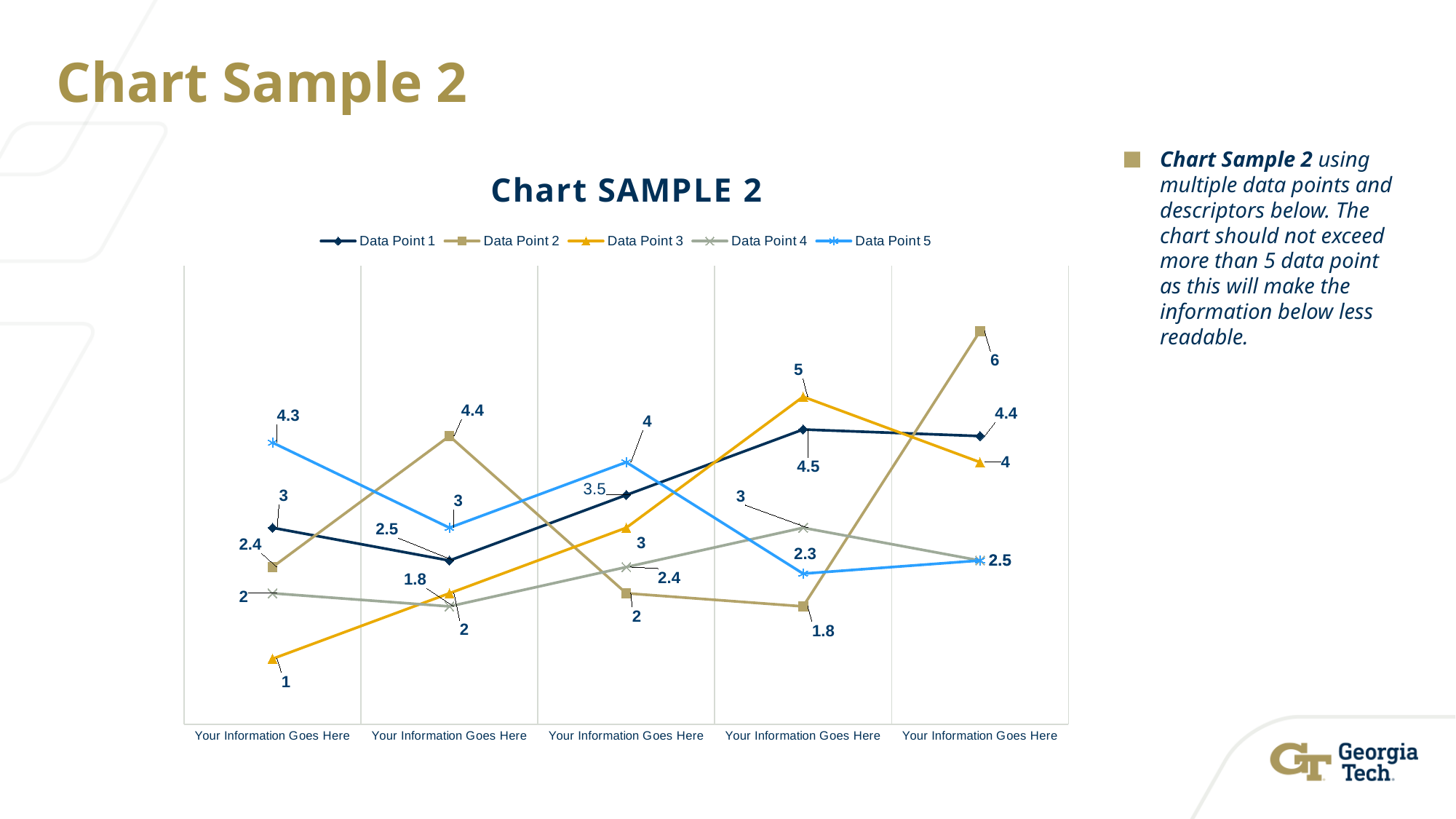
What is the title of the chart? Chart SAMPLE 2 What is the value of Data Point 1 at the fourth category? 4.5 Which series reaches the highest value anywhere on the chart? Data Point 2 What is the value of Data Point 2 at the fifth (last) category? 6 What is the difference between Data Point 2's value at the fifth category and its value at the fourth category? 4.2 What kind of chart is shown on the slide? line chart How many series does the chart legend list? 5 How many categories are plotted along the x axis? 5 At which category does Data Point 3 reach its lowest value? the first category What is the value of Data Point 5 at the first category? 4.3 What is the value of Data Point 3 at the first category? 1 At the first category, which is larger: Data Point 5 or Data Point 1? Data Point 5